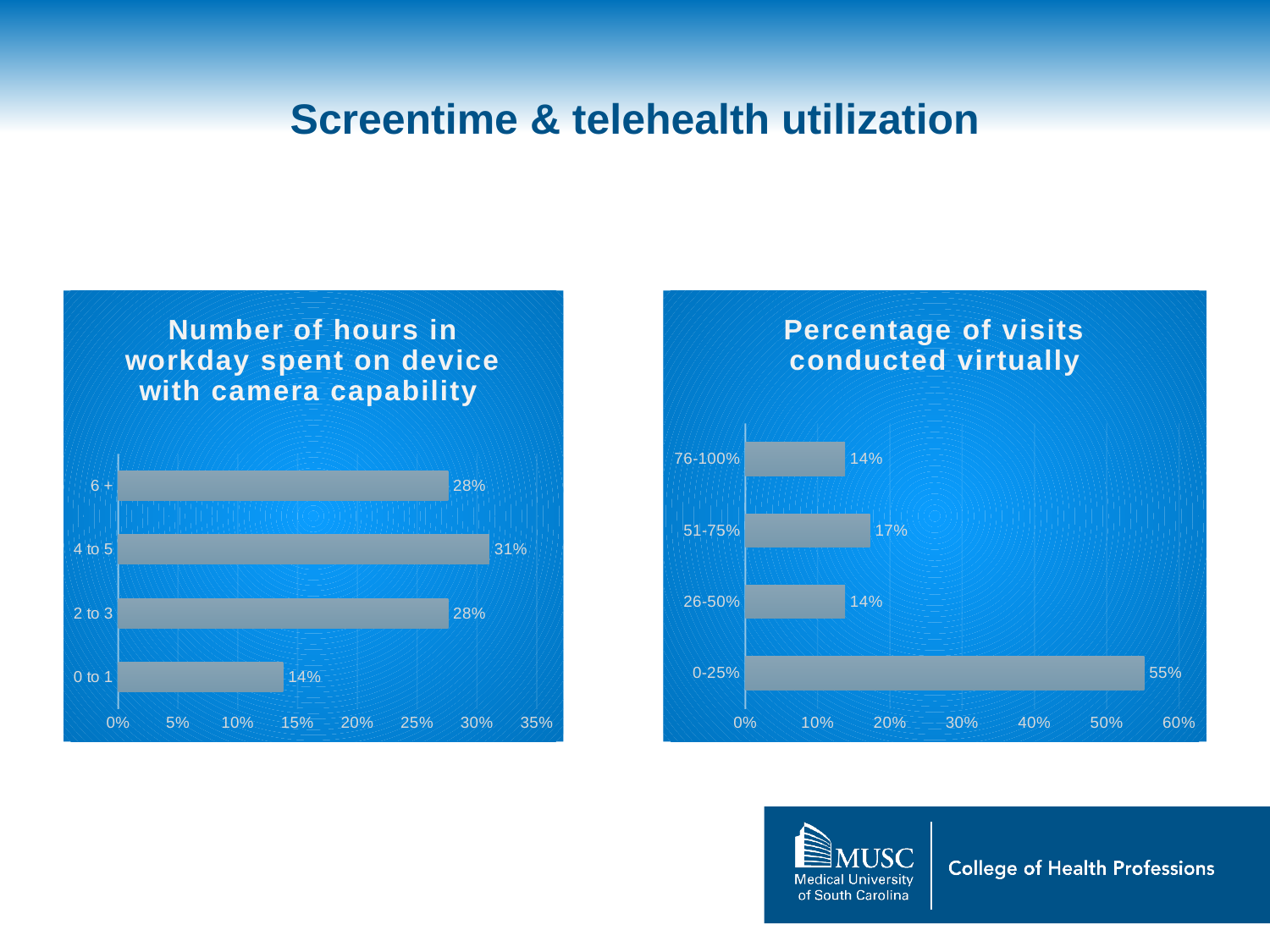
In the 'Percentage of visits conducted virtually' chart, which is larger, the value for '51-75%' or the value for '26-50%'? 51-75% In the 'Percentage of visits conducted virtually' chart, what is the value for '0-25%'? 55% In the 'Number of hours in workday spent on device with camera capability' chart, what is the value for '4 to 5'? 31% In the 'Number of hours in workday spent on device with camera capability' chart, how many categories are shown? 4 In the 'Percentage of visits conducted virtually' chart, which category has the highest value? 0-25% In the 'Number of hours in workday spent on device with camera capability' chart, which category has the lowest value? 0 to 1 In the 'Percentage of visits conducted virtually' chart, what is the value for '51-75%'? 17% In the 'Percentage of visits conducted virtually' chart, what is the difference between the values for '0-25%' and '51-75%'? 38% In the 'Number of hours in workday spent on device with camera capability' chart, what is the value for '0 to 1'? 14% In the 'Number of hours in workday spent on device with camera capability' chart, which category has the highest value? 4 to 5 In the 'Number of hours in workday spent on device with camera capability' chart, what is the difference between the values for '4 to 5' and '0 to 1'? 17% What kind of chart is the 'Percentage of visits conducted virtually' chart? Bar chart